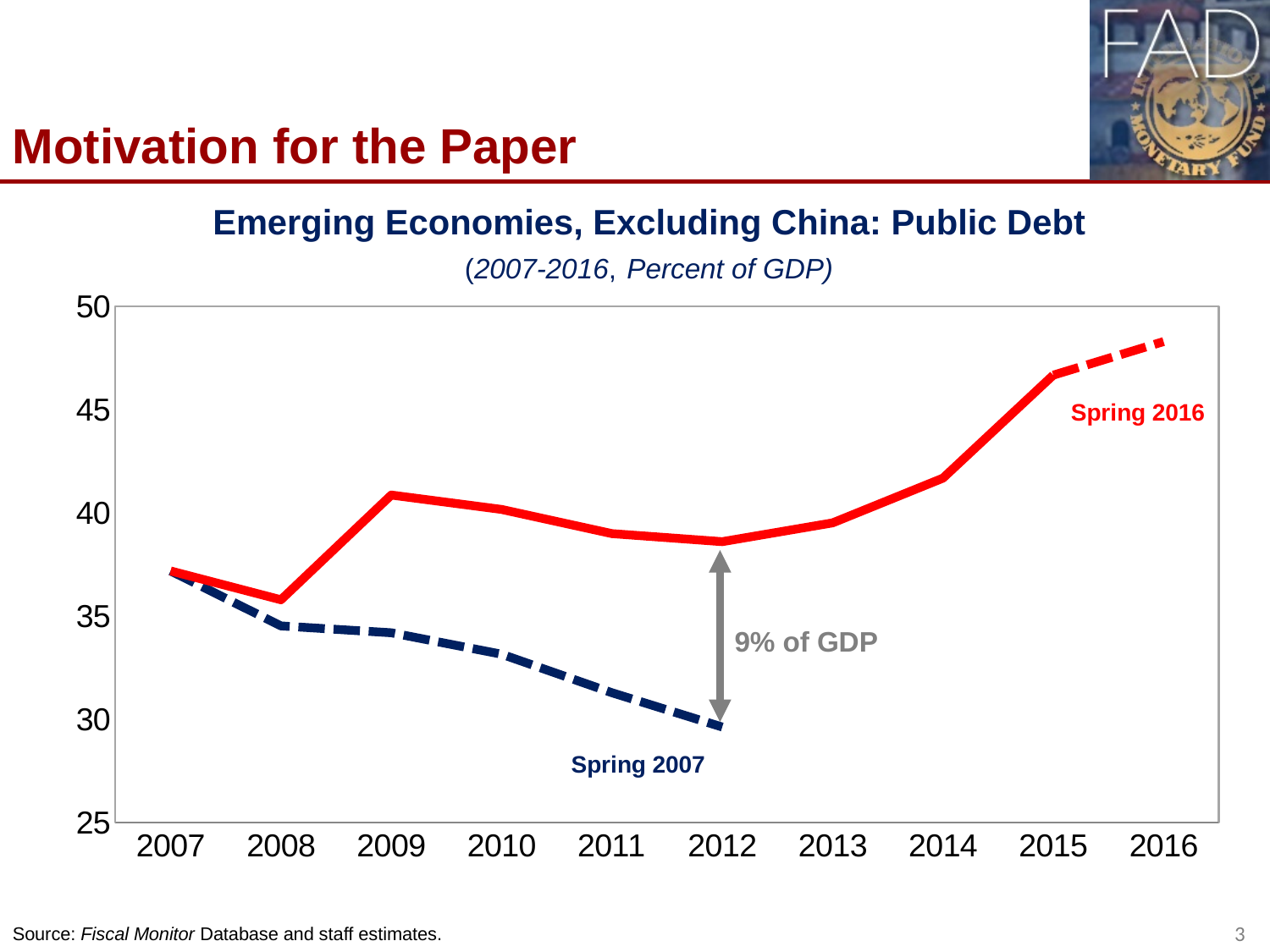
What is the title of the chart? Emerging Economies, Excluding China: Public Debt In which year does the Spring 2007 series reach its lowest value? 2012 Does the Spring 2007 series rise or fall from 2007 to 2012? fall How many series are plotted on the chart? 2 Is the Spring 2016 value for 2015 greater or less than 45? greater According to the annotation, what is the gap between the Spring 2016 and Spring 2007 lines in 2012? 9% of GDP In which year does the Spring 2016 series reach its lowest value? 2008 In 2012, which series has the larger value, Spring 2016 or Spring 2007? Spring 2016 Is the Spring 2007 value for 2010 greater or less than 35? less In which year does the Spring 2016 series reach its highest value? 2016 What kind of chart is shown on the slide? line chart How many years are shown along the x axis? 10